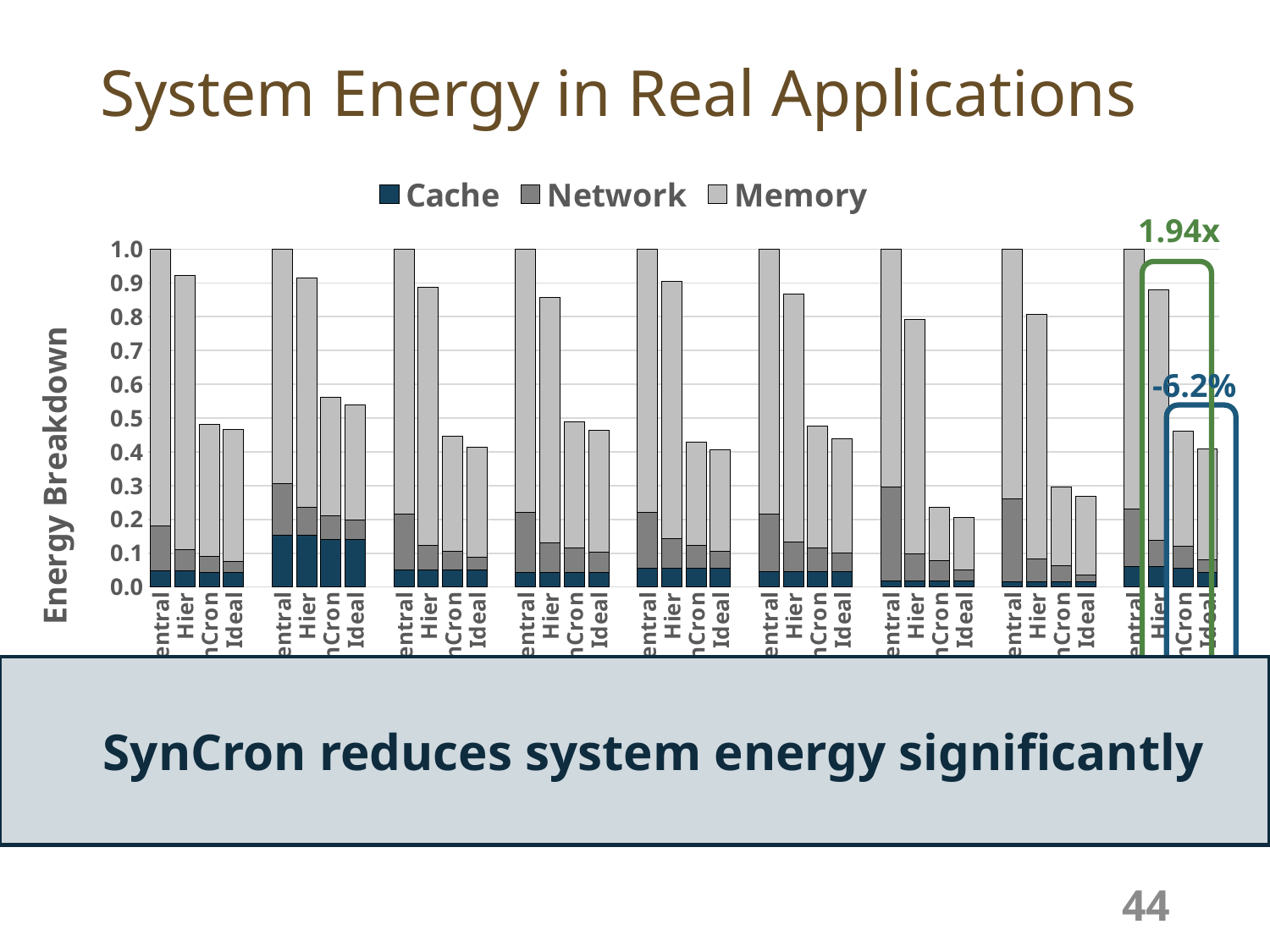
What kind of chart is shown on the slide? bar chart Within the leftmost group, do the bar totals rise or fall from left to right? fall What is the total height of the first (leftmost) bar in the leftmost group? 1.0 In the leftmost group, which bar is taller, Hier or Ideal? Hier How many bars are in each group of bars on the chart? 4 How many series does the legend list? 3 What is the title of the vertical axis? Energy Breakdown In the rightmost group, is the total for the Ideal bar greater or less than 0.5? less In the leftmost group, is the total for the Hier bar greater or less than 0.9? greater In the leftmost group, is the total for the Ideal bar greater or less than 0.5? less How many groups of bars are plotted on the chart? 9 What are the three series named in the legend? Cache, Network, Memory